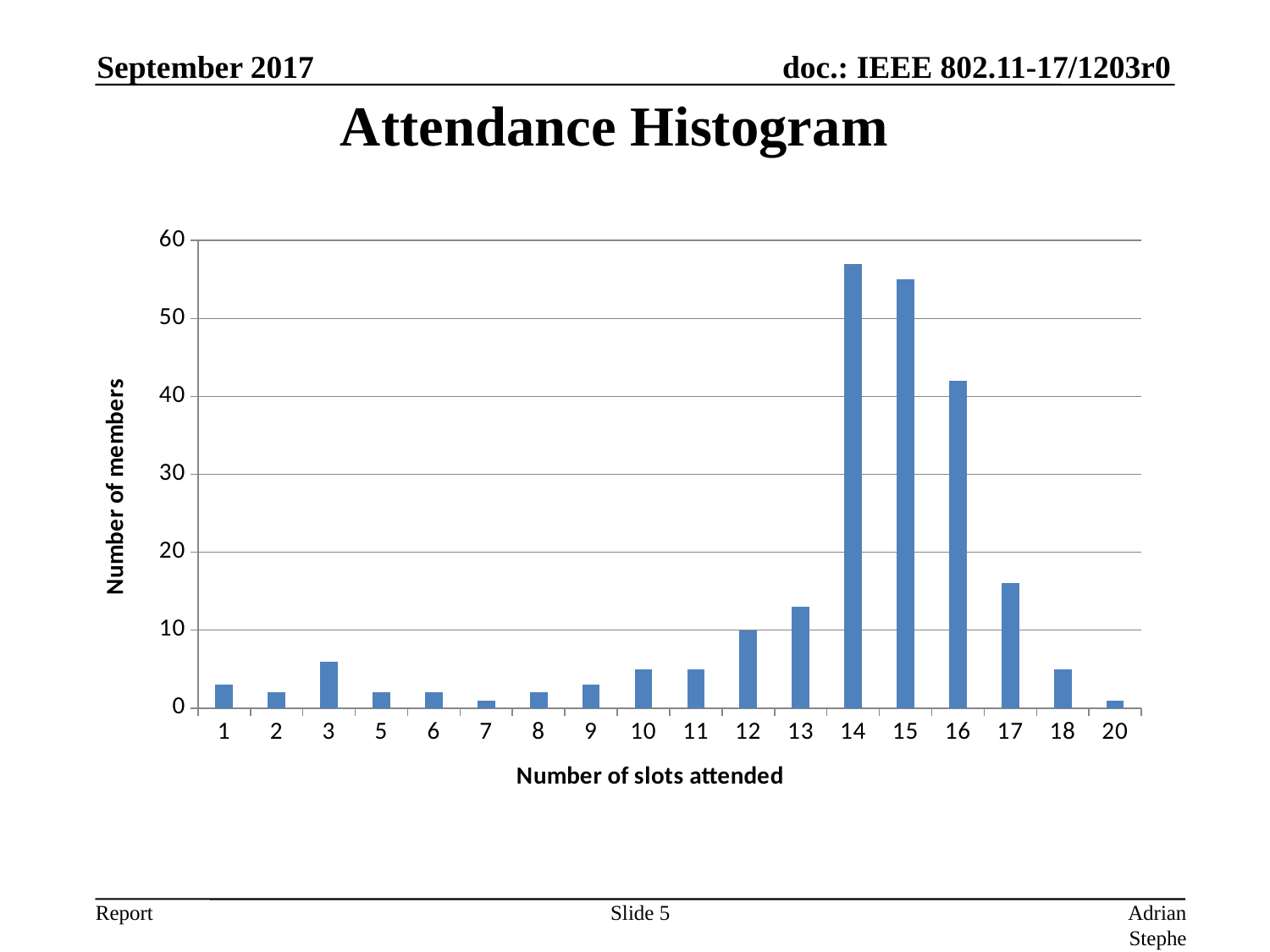
How many categories are shown on the x axis? 18 Is the number of members for 17 slots attended greater or less than 10? greater Is the number of members for 3 slots attended greater or less than 10? less Which has more members: 16 slots attended or 17 slots attended? 16 Which number of slots attended has the highest number of members? 14 Is the number of members for 14 slots attended greater or less than 50? greater What is the title of the chart? Attendance Histogram Do the values rise or fall from 14 slots attended to 20 slots attended? fall What kind of chart is shown on the slide? bar chart What is the label of the x axis? Number of slots attended Which has more members: 13 slots attended or 18 slots attended? 13